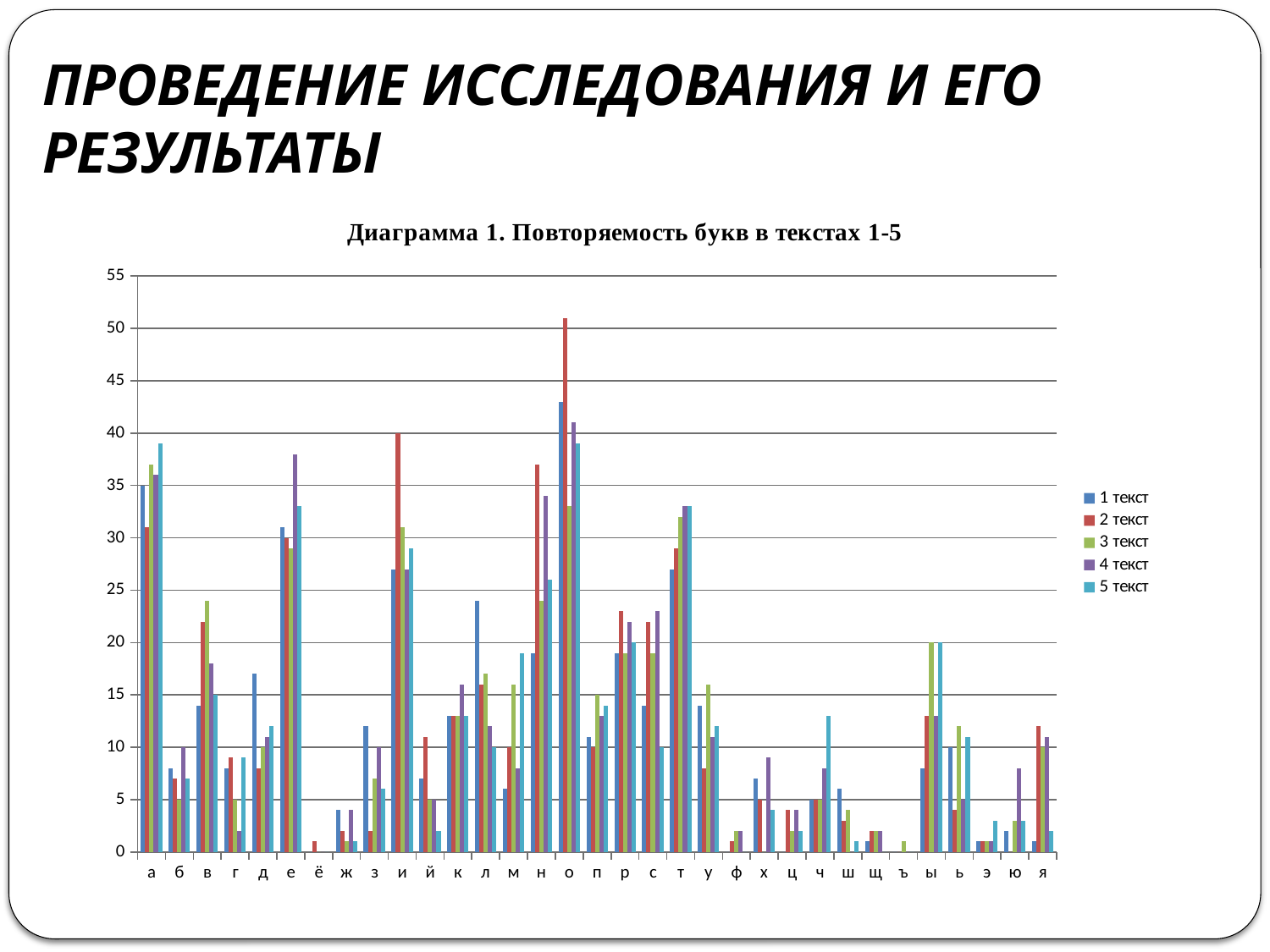
Which letter has the highest value for the series 2 текст? о Is the value for 1 текст at letter д greater or less than 15? greater How many letter categories are shown on the x axis? 33 Is the value for 2 текст at letter и greater or less than 35? greater Which letter has the highest value for the series 4 текст? о Is the value for 2 текст at letter о greater or less than 45? greater At letter е, which is larger: the value for 4 текст or for 5 текст? 4 текст What kind of chart is shown on the slide? bar chart What is the title of the chart? Диаграмма 1. Повторяемость букв в текстах 1-5 How many series does the legend list? 5 At letter и, which is larger: the value for 1 текст or for 2 текст? 2 текст Which letter has the highest value for the series 1 текст? о